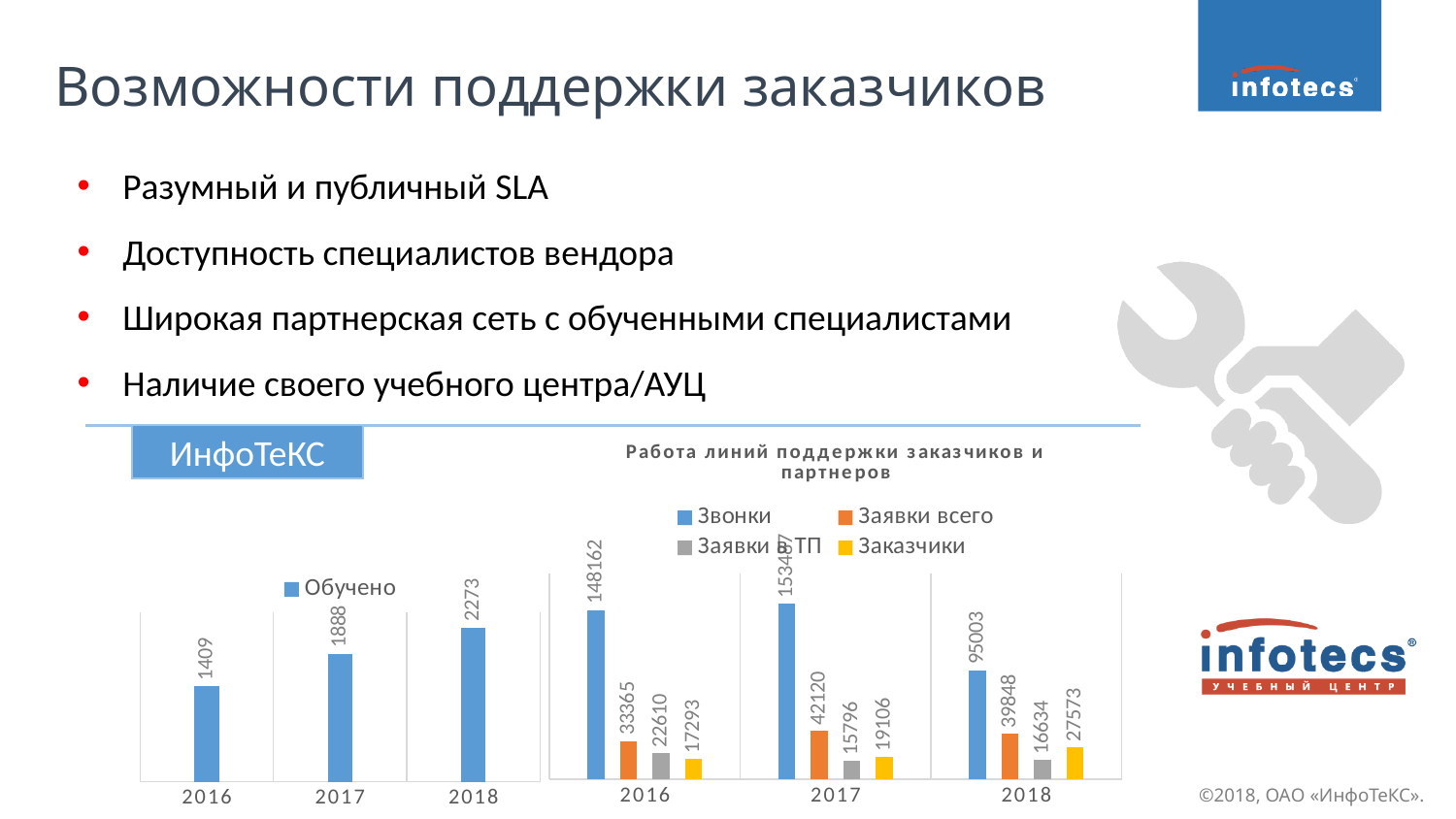
In the left chart with the legend 'Обучено', how many years are shown on the x axis? 3 In the chart 'Работа линий поддержки заказчиков и партнеров', what is the value of Заявки в ТП for 2017? 15796 What type of chart is 'Работа линий поддержки заказчиков и партнеров'? bar chart In the chart 'Работа линий поддержки заказчиков и партнеров', what is the value of Звонки for 2016? 148162 In the left chart with the legend 'Обучено', what is the difference between the 2018 and 2016 values? 864 In the chart 'Работа линий поддержки заказчиков и партнеров', which is larger for 2018: Заявки всего or Заказчики? Заявки всего In the left chart with the legend 'Обучено', what is the value for 2016? 1409 In the chart 'Работа линий поддержки заказчиков и партнеров', how many series does the legend list? 4 In the chart 'Работа линий поддержки заказчиков и партнеров', what is the value of Заказчики for 2018? 27573 In the left chart with the legend 'Обучено', what is the value for 2018? 2273 In the chart 'Работа линий поддержки заказчиков и партнеров', which year has the lowest value for Звонки? 2018 In the left chart with the legend 'Обучено', do the values rise or fall from 2016 to 2018? rise